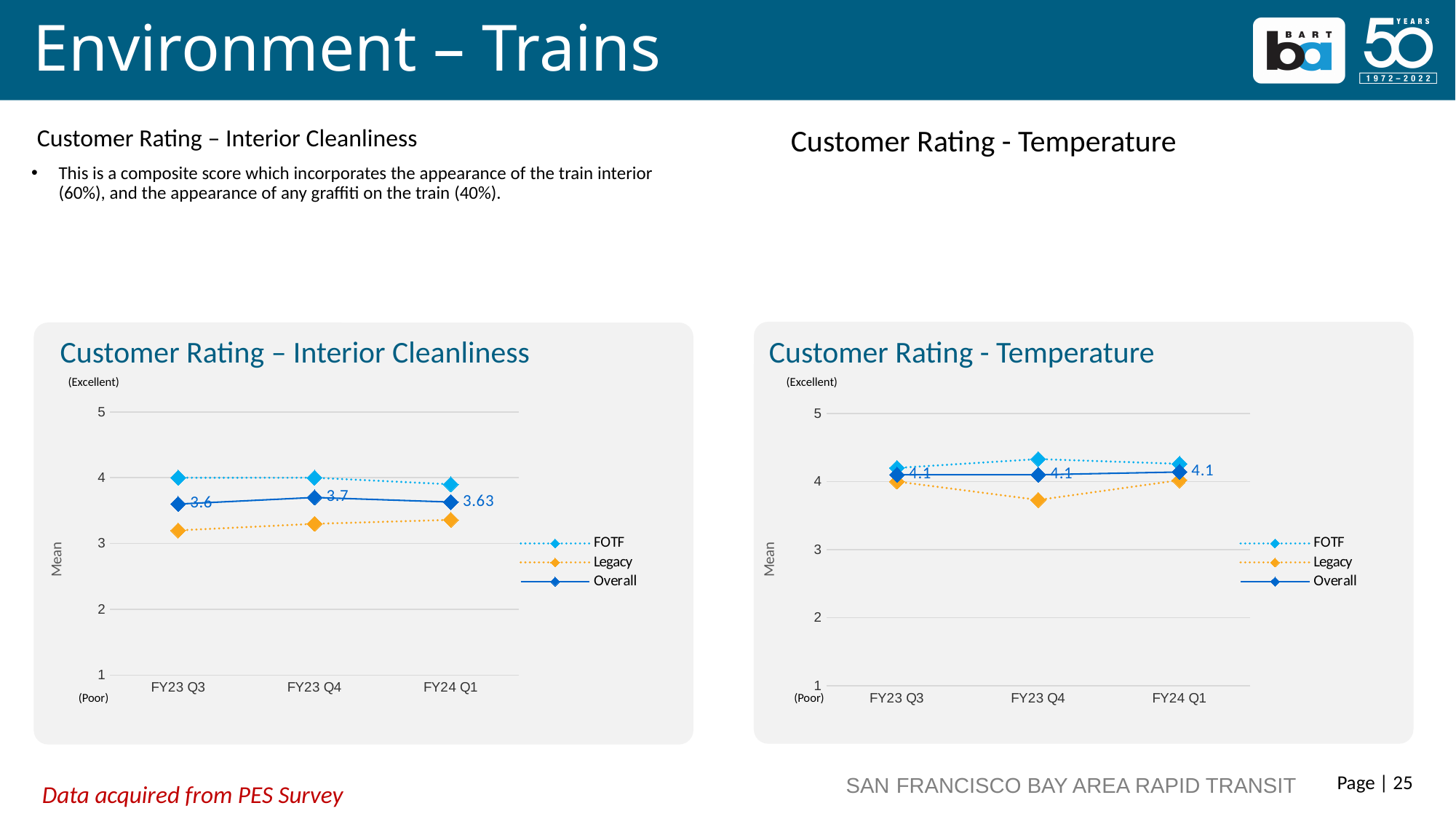
What kind of chart is the Customer Rating - Temperature chart? Line chart In the Customer Rating – Interior Cleanliness chart, which series is higher at FY23 Q4, FOTF or Legacy? FOTF In the Customer Rating – Interior Cleanliness chart, is the Legacy value for FY23 Q3 greater or less than 4? less In the Customer Rating - Temperature chart, is the Legacy value for FY23 Q4 greater or less than 4? less In the Customer Rating – Interior Cleanliness chart, what is the difference between the Overall values for FY23 Q4 and FY23 Q3? 0.1 How many series does the legend of the Customer Rating - Temperature chart list? 3 In the Customer Rating – Interior Cleanliness chart, what is the Overall value for FY23 Q3? 3.6 In the Customer Rating - Temperature chart, which series is lowest at FY23 Q4? Legacy In the Customer Rating – Interior Cleanliness chart, which quarter has the highest Overall value? FY23 Q4 In the Customer Rating - Temperature chart, what is the Overall value for FY23 Q4? 4.1 In the Customer Rating – Interior Cleanliness chart, what is the Overall value for FY24 Q1? 3.63 How many quarters are plotted on the x axis of the Customer Rating – Interior Cleanliness chart? 3